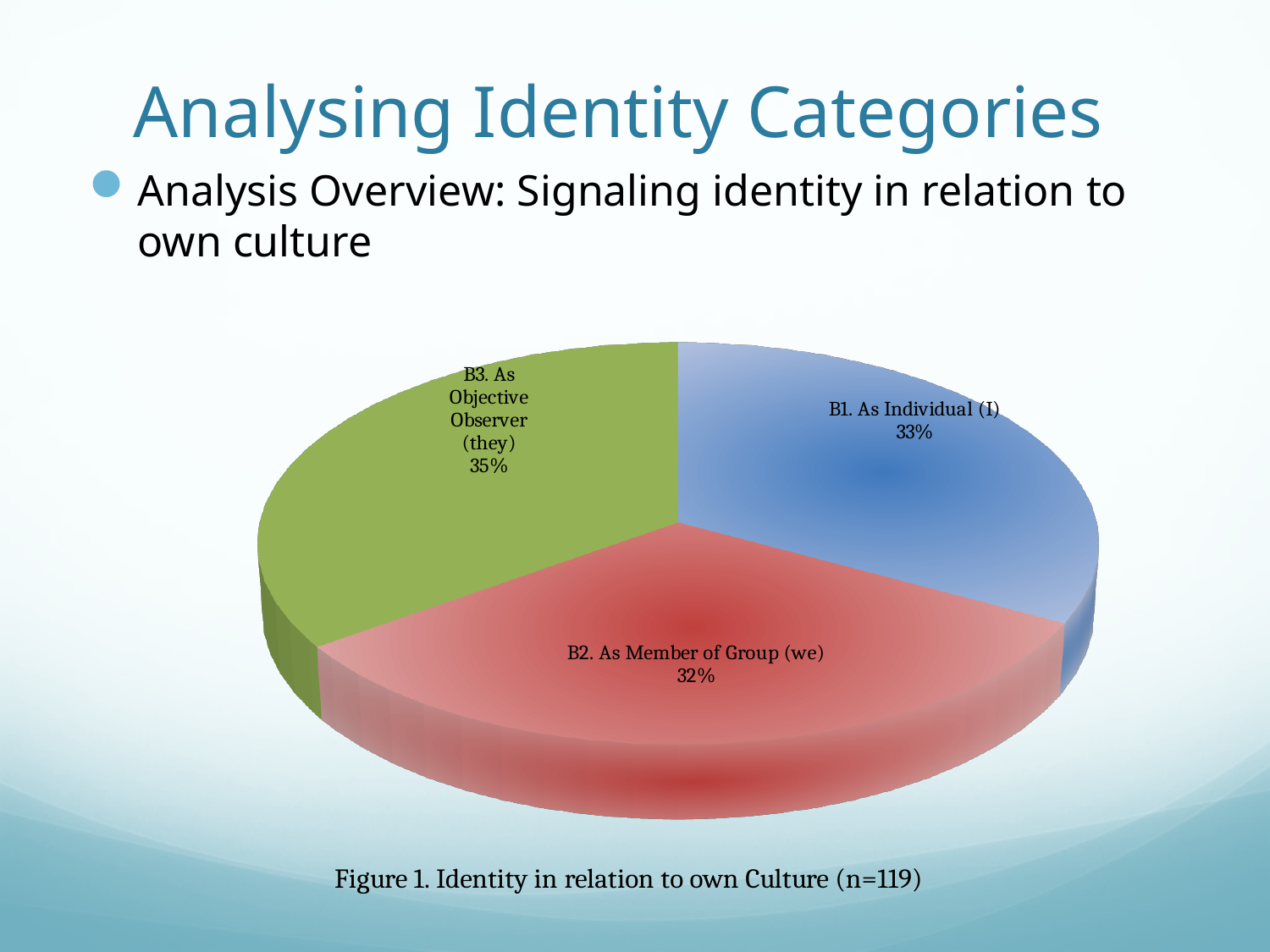
What is the sample size (n) stated in the figure caption? 119 Which category has the smallest share of the pie? B2. As Member of Group (we) What is the difference in percentage points between B3. As Objective Observer (they) and B2. As Member of Group (we)? 3 What kind of chart is shown on the slide? pie chart What percentage is shown for B2. As Member of Group (we)? 32% How many slices does the pie chart have? 3 What colour is the slice for B2. As Member of Group (we)? red What percentage is shown for B3. As Objective Observer (they)? 35% What is the difference in percentage points between B1. As Individual (I) and B2. As Member of Group (we)? 1 What percentage is shown for B1. As Individual (I)? 33% What is the caption of the figure below the pie chart? Figure 1. Identity in relation to own Culture (n=119) Which category has the largest share of the pie? B3. As Objective Observer (they)